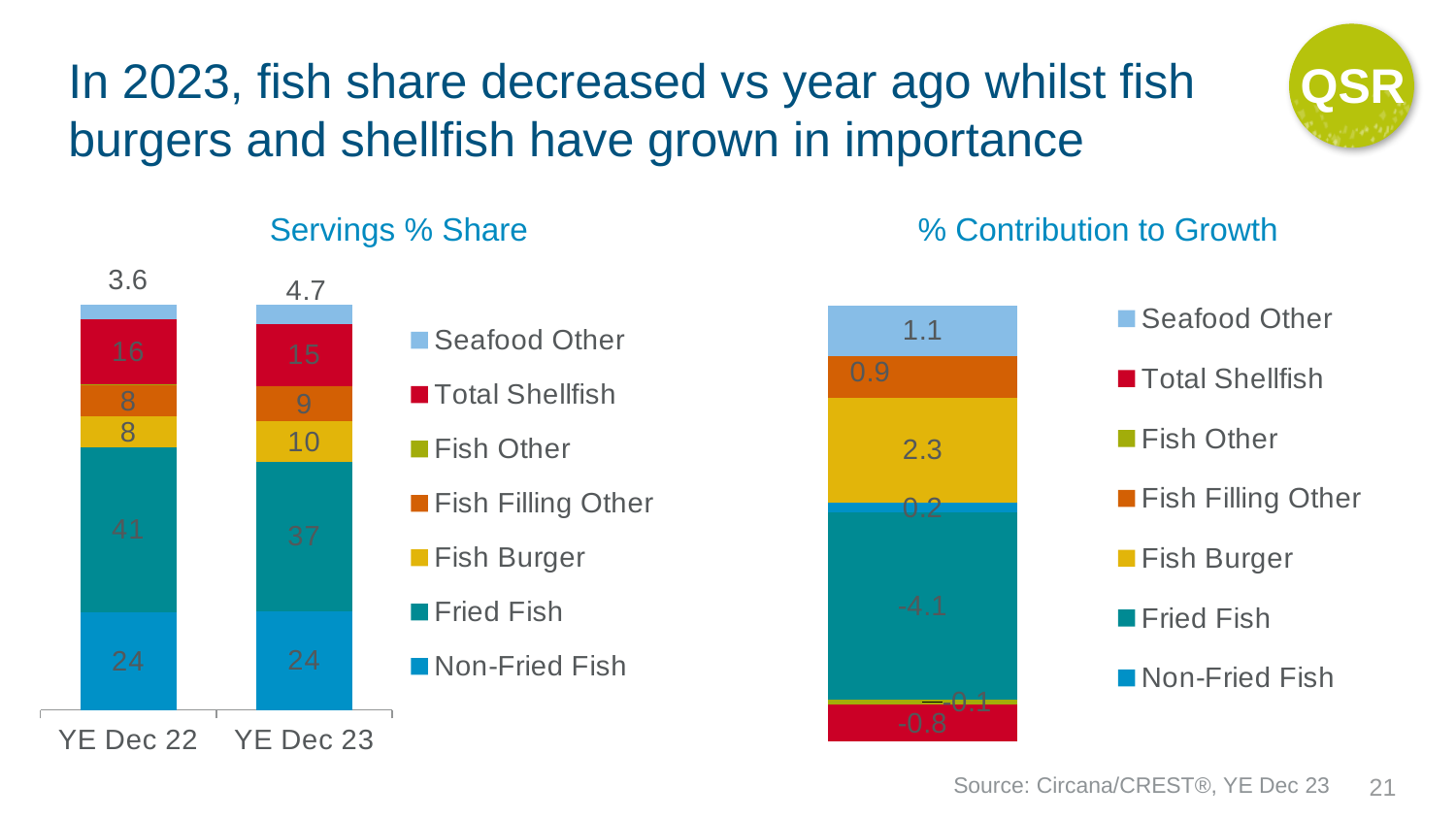
In the Servings % Share chart, by how much did the Fried Fish value fall from YE Dec 22 to YE Dec 23? 4 In the % Contribution to Growth chart, which category has the largest positive contribution? Fish Burger In the Servings % Share chart, how many bars (time periods) are shown? 2 In the Servings % Share chart, what is the value for Fried Fish in YE Dec 23? 37 How many series does the legend of the Servings % Share chart list? 7 In the Servings % Share chart, what is the value for Fish Burger in YE Dec 23? 10 In the % Contribution to Growth chart, what is the value for Fried Fish? -4.1 In the Servings % Share chart, what is the value for Seafood Other in YE Dec 23? 4.7 In the Servings % Share chart, what is the value for Fried Fish in YE Dec 22? 41 In the Servings % Share chart, is the Total Shellfish value larger in YE Dec 22 or YE Dec 23? YE Dec 22 In the % Contribution to Growth chart, which category has the lowest (most negative) contribution? Fried Fish In the % Contribution to Growth chart, what is the value for Fish Burger? 2.3